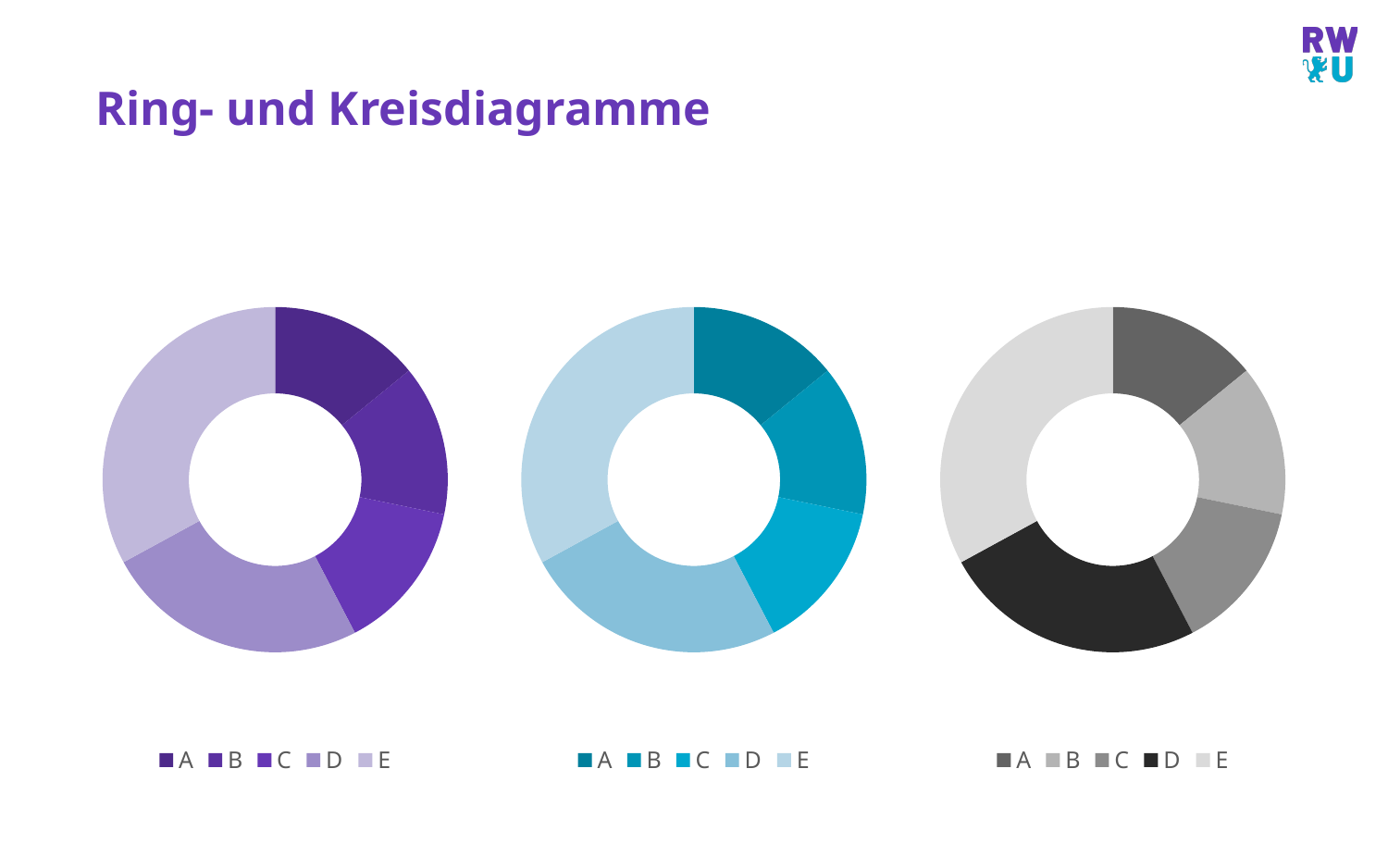
What kind of chart is the left chart on the slide? doughnut chart In the right chart, which category has the largest slice? E How many entries does the legend of the right chart list? 5 In the left chart, which category has the largest slice? E In the middle chart, which category has the largest slice? E In the right chart, which slice is larger, C or D? D What colour family is used for the slices of the middle chart? blue How many categories does the legend of the middle chart list? 5 In the middle chart, which slice is larger, E or B? E What is the title of the slide containing the three doughnut charts? Ring- und Kreisdiagramme In the left chart, which slice is larger, D or A? D How many doughnut charts are shown on the slide? 3